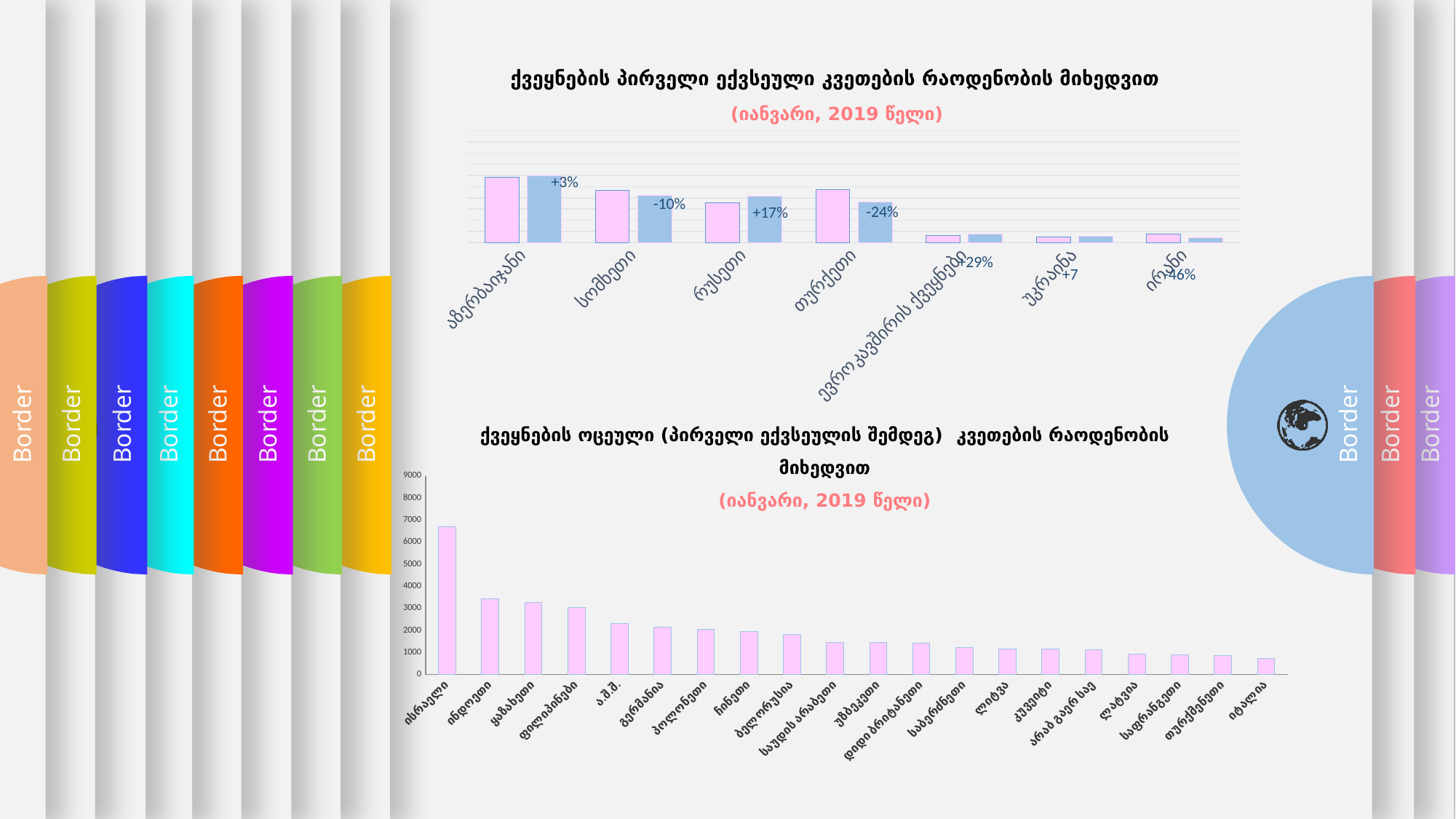
In the top chart, which category has the tallest pink bar? აზერბაიჯანი In the top chart, what is the data label shown for აზერბაიჯანი? +3% In the bottom chart, is the value for ისრაელი greater or less than 6000? greater In the top chart, what is the data label shown for თურქეთი? -24% In the bottom chart, which country has the highest value? ისრაელი In the bottom chart, which country has the lowest value? იტალია In the top chart, what is the data label shown for ირანი? -46% In the bottom chart, how many countries are shown on the x axis? 20 In the top chart, which pink bar is taller, აზერბაიჯანი or სომხეთი? აზერბაიჯანი In the top chart, how many countries/categories are shown on the x axis? 7 In the bottom chart, do the values rise or fall from left to right along the x axis? fall What kind of chart is the top chart on the slide? bar chart